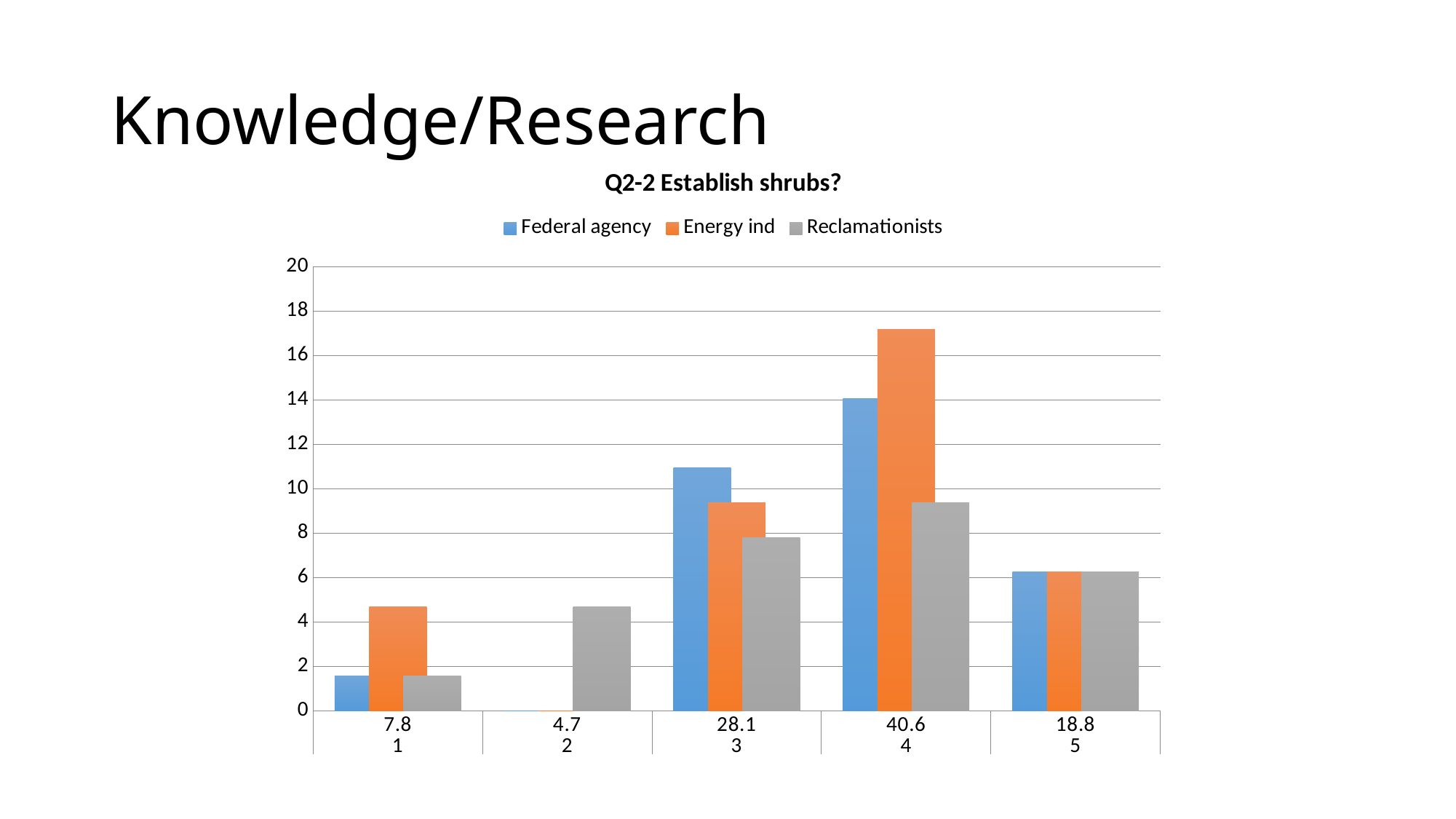
How many categories are shown along the x axis? 5 In category 3, which is larger: the Federal agency value or the Reclamationists value? Federal agency Is the Federal agency value for category 3 greater or less than 10? greater What is the title of the chart? Q2-2 Establish shrubs? What kind of chart is shown on the slide? bar chart For which category is the Federal agency value highest? 4 How many series does the legend list? 3 For which category is the Energy ind value highest? 4 Is the Energy ind value for category 4 greater or less than 16? greater Is the Reclamationists value for category 2 greater or less than 6? less Which series is shown in orange in the legend? Energy ind In category 4, which is larger: the Energy ind value or the Reclamationists value? Energy ind